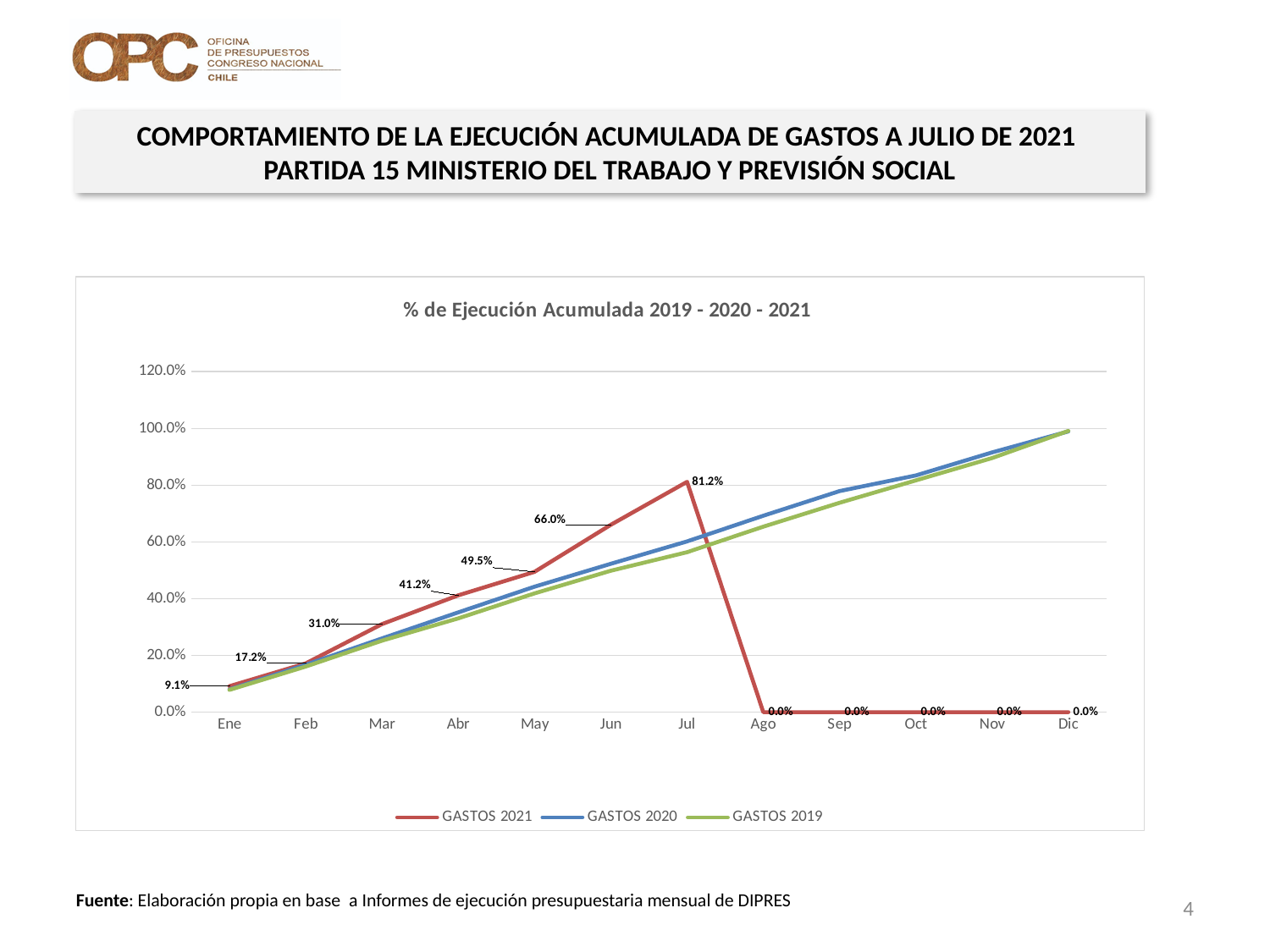
What type of chart is shown on the slide? line chart What is the value of GASTOS 2021 for Ene? 9.1% How many series does the chart legend list? 3 Does the GASTOS 2019 line rise or fall from Ene to Dic? rise What is the value of GASTOS 2021 for Abr? 41.2% What is the difference between the GASTOS 2021 values for Jul and Jun? 15.2% What is the value of GASTOS 2021 for Ago? 0.0% What is the title of the chart? % de Ejecución Acumulada 2019 - 2020 - 2021 In which month does GASTOS 2021 reach its highest value? Jul How many months are shown on the x axis of the chart? 12 What is the value of GASTOS 2021 for Jul? 81.2% Is the value of GASTOS 2020 for Sep greater or less than 60.0%? greater